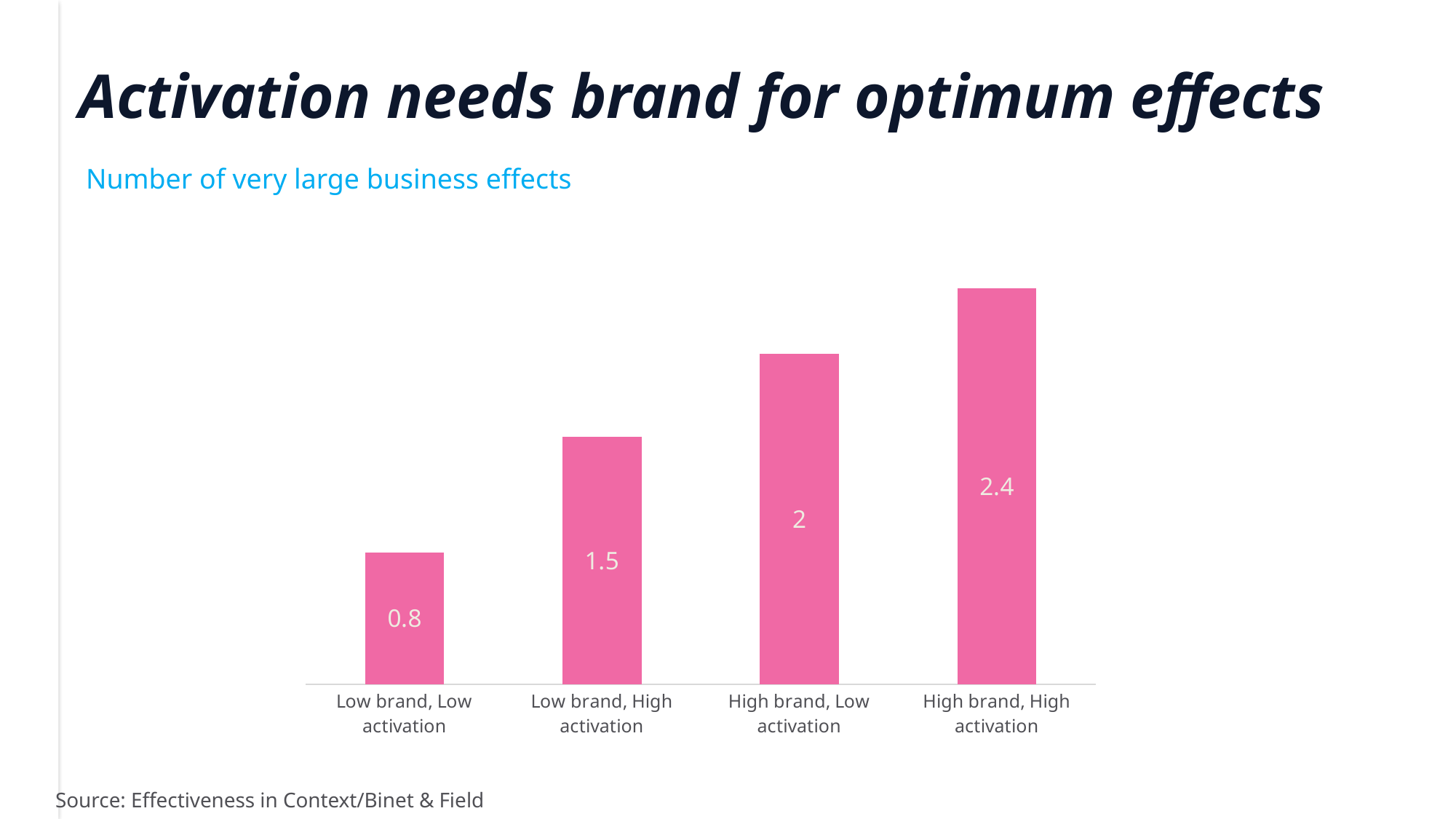
Which category has the lowest number of very large business effects? Low brand, Low activation How many categories are shown in the chart? 4 What is the number of very large business effects for High brand, High activation? 2.4 What is the number of very large business effects for Low brand, Low activation? 0.8 What kind of chart is shown on the slide? Bar chart Which is larger: the value for High brand, Low activation or Low brand, High activation? High brand, Low activation What is the number of very large business effects for Low brand, High activation? 1.5 What is the number of very large business effects for High brand, Low activation? 2 What is the difference between the values for High brand, High activation and Low brand, Low activation? 1.6 What is the difference between the values for High brand, Low activation and Low brand, High activation? 0.5 Which category has the highest number of very large business effects? High brand, High activation Do the values rise or fall from left to right across the categories? Rise